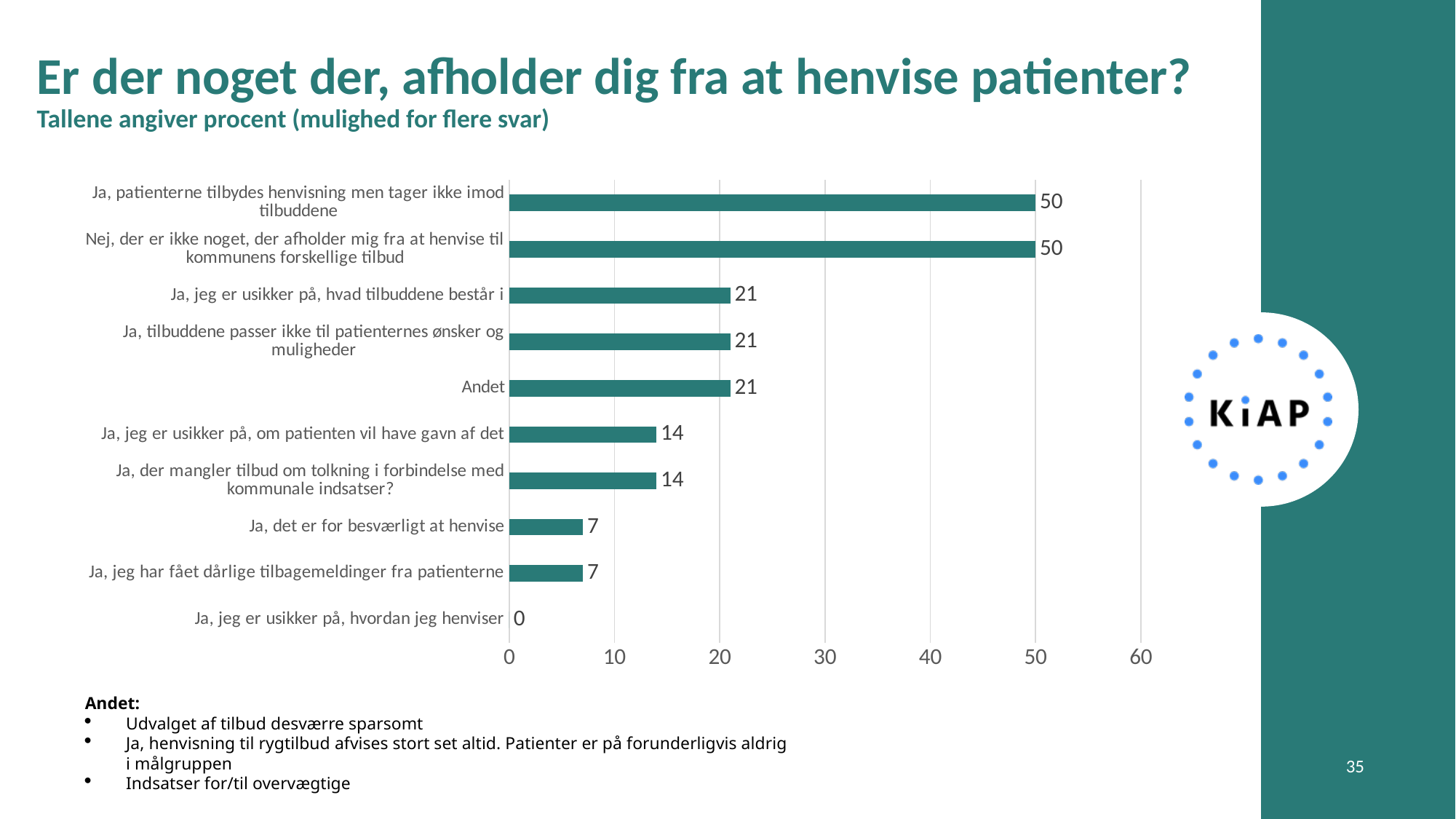
What value is shown for "Nej, der er ikke noget, der afholder mig fra at henvise til kommunens forskellige tilbud"? 50 Which category has the lowest value in the chart? Ja, jeg er usikker på, hvordan jeg henviser How many categories are shown in the chart? 10 What kind of chart is shown on the slide? Bar chart Is the value for "Ja, jeg har fået dårlige tilbagemeldinger fra patienterne" greater or less than 10? less What value is shown for "Ja, jeg er usikker på, om patienten vil have gavn af det"? 14 What value is shown for "Ja, jeg er usikker på, hvad tilbuddene består i"? 21 What is the difference between the value for "Ja, patienterne tilbydes henvisning men tager ikke imod tilbuddene" and the value for "Andet"? 29 What value is shown for "Ja, det er for besværligt at henvise"? 7 Which has a larger value: "Andet" or "Ja, det er for besværligt at henvise"? Andet What is the highest value shown on the chart's horizontal axis? 60 What is the difference between the value for "Ja, der mangler tilbud om tolkning i forbindelse med kommunale indsatser?" and the value for "Ja, jeg har fået dårlige tilbagemeldinger fra patienterne"? 7